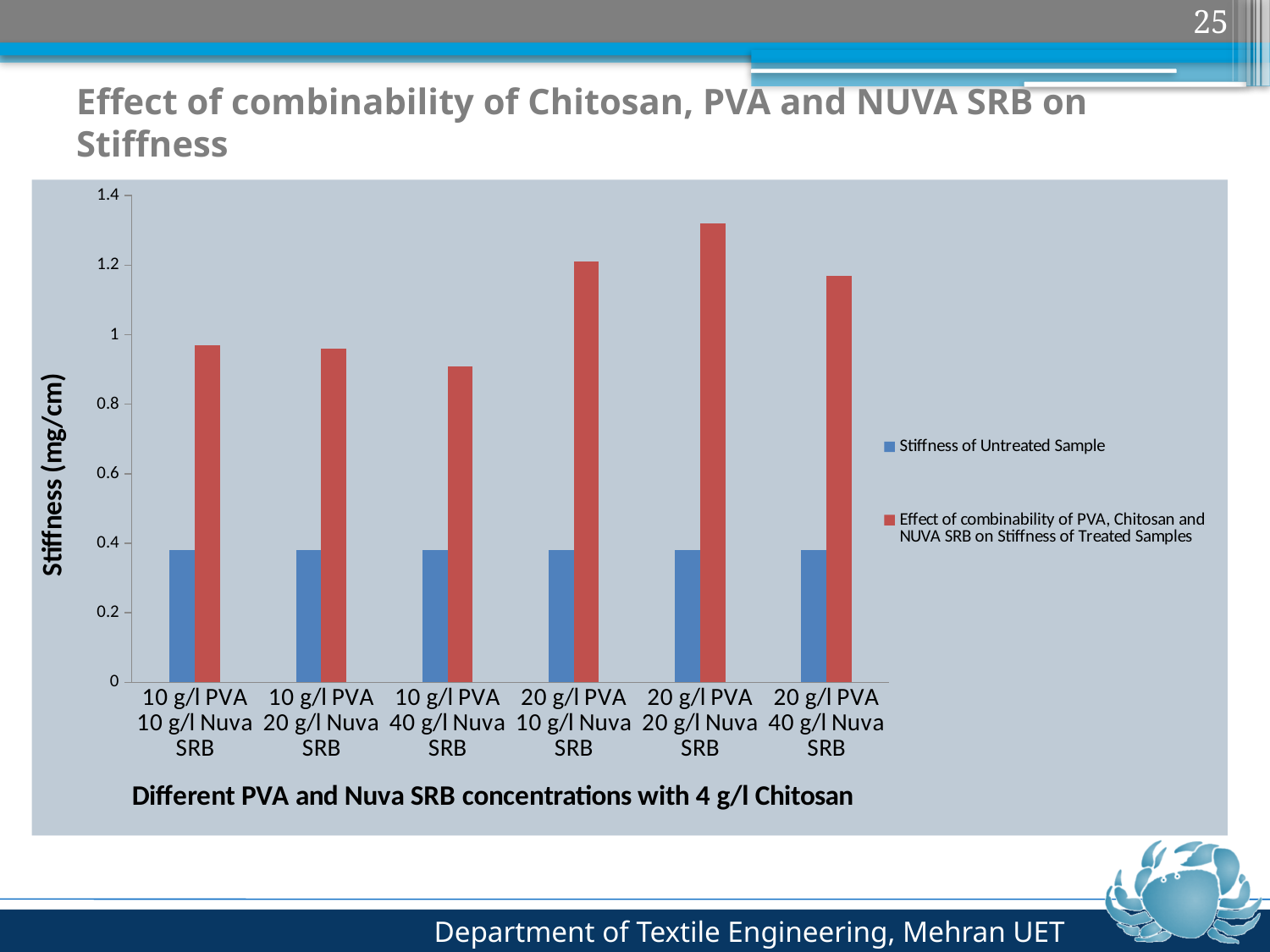
Is the treated-sample stiffness for 20 g/l PVA 20 g/l Nuva SRB greater or less than 1.2? greater Which is larger for treated samples: the stiffness at 20 g/l PVA 40 g/l Nuva SRB or at 10 g/l PVA 10 g/l Nuva SRB? 20 g/l PVA 40 g/l Nuva SRB What is the label of the y axis? Stiffness (mg/cm) Is the treated-sample stiffness for 20 g/l PVA 10 g/l Nuva SRB greater or less than 1? greater What kind of chart is shown on the slide? bar chart What colour are the bars for the Stiffness of Untreated Sample series? blue Is the stiffness of the untreated sample greater or less than 0.4? less Which concentration has the highest stiffness for the treated samples? 20 g/l PVA 20 g/l Nuva SRB For every concentration, which series has the higher stiffness: the untreated sample or the treated samples? Effect of combinability of PVA, Chitosan and NUVA SRB on Stiffness of Treated Samples How many concentration categories are shown on the x axis? 6 How many series does the legend list? 2